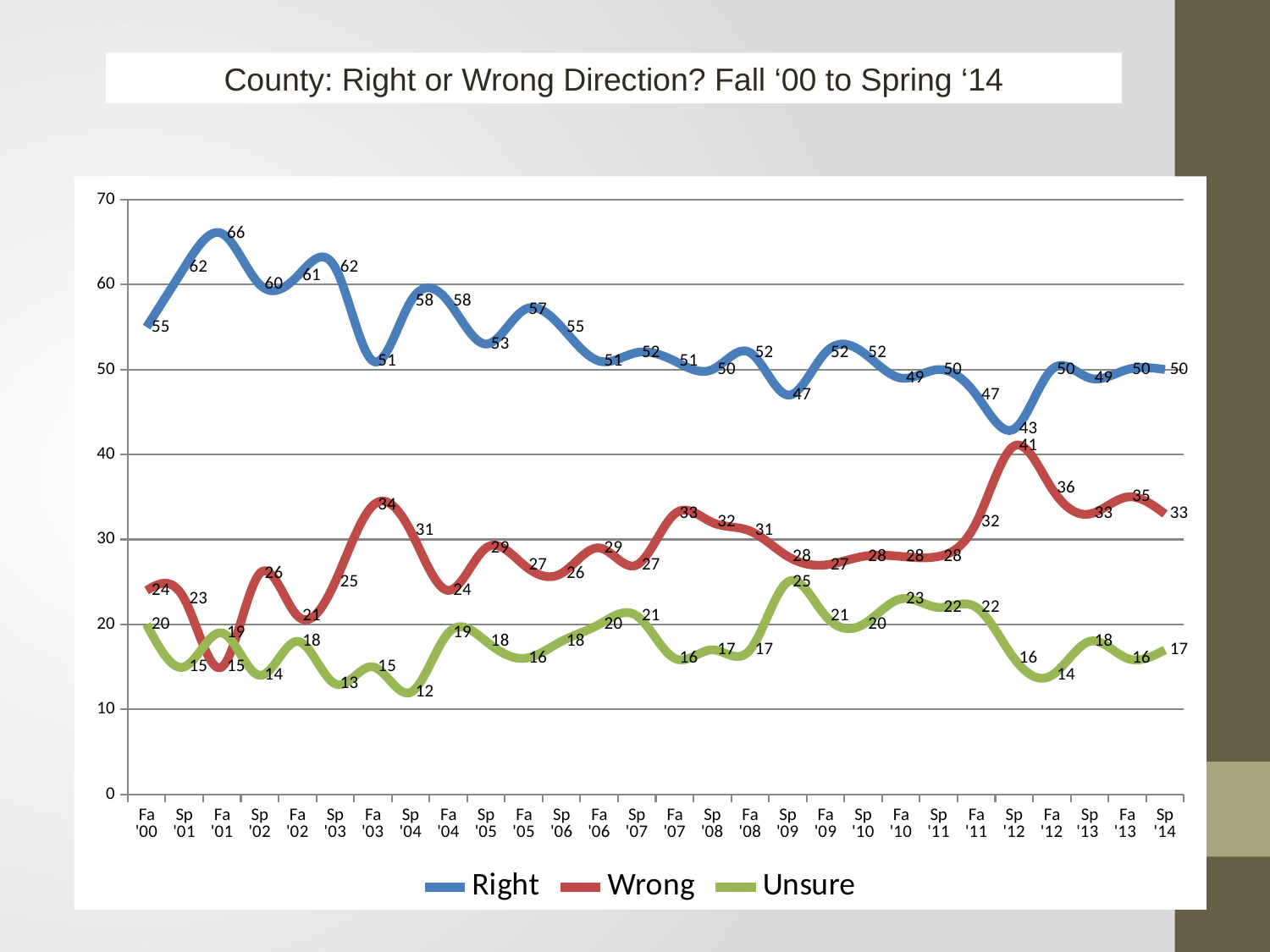
At which period does the Unsure series reach its lowest value? Sp '04 What is the difference between the Right and Wrong values at Sp '14? 17 At which period does the Right series reach its lowest value? Sp '12 What kind of chart is this? Line chart Which is larger at Fa '03: the Wrong value or the Unsure value? Wrong What is the value of the Wrong series at Sp '12? 41 What is the title of the chart? County: Right or Wrong Direction? Fall '00 to Spring '14 At which period does the Wrong series reach its highest value? Sp '12 What is the value of the Unsure series at Sp '09? 25 What is the value of the Right series at Fa '01? 66 How many time periods are shown on the x axis? 28 How many series does the legend list? 3